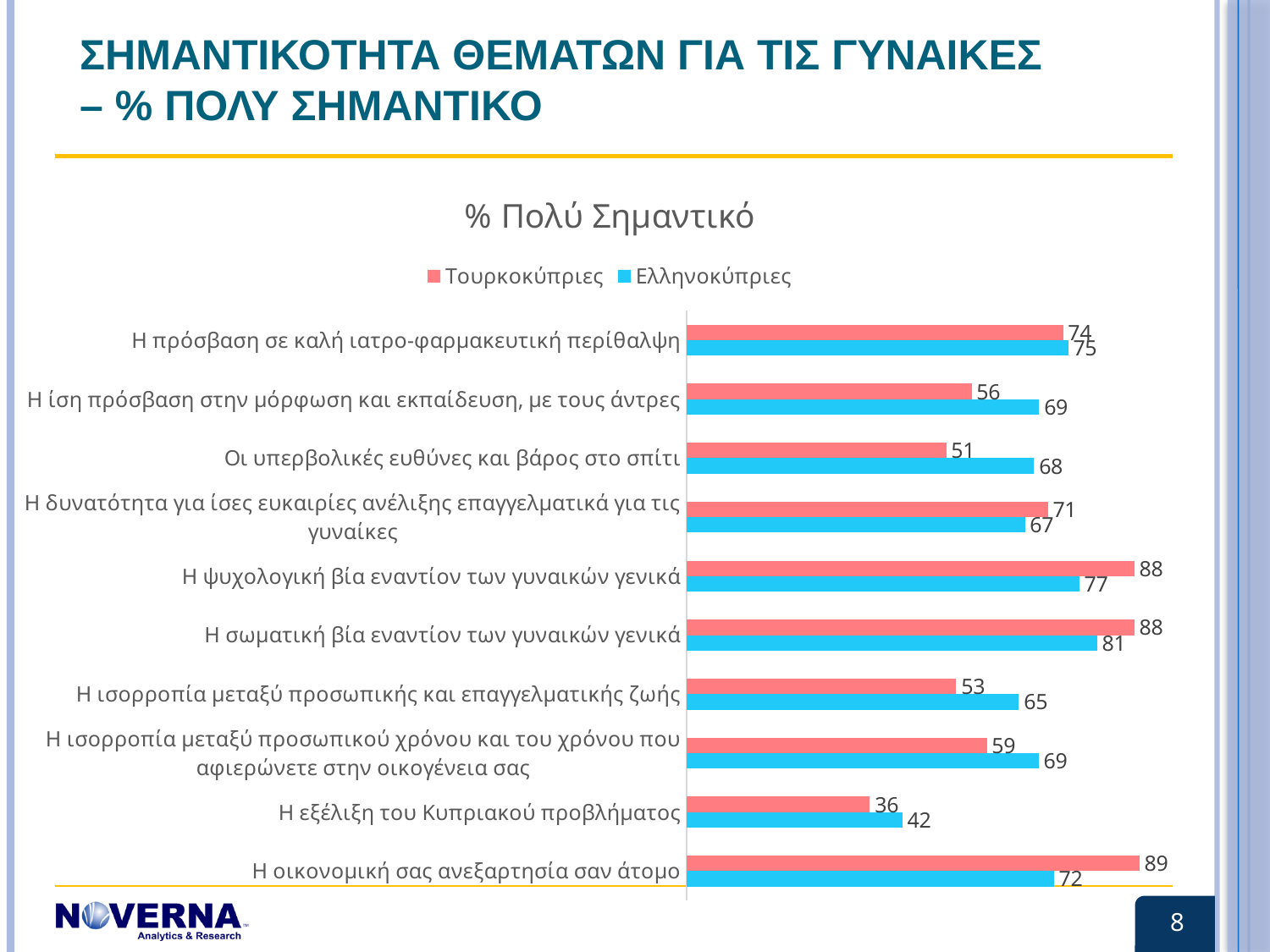
For 'Η δυνατότητα για ίσες ευκαιρίες ανέλιξης επαγγελματικά για τις γυναίκες', which group has the larger value, Τουρκοκύπριες or Ελληνοκύπριες? Τουρκοκύπριες Which category has the highest value for Τουρκοκύπριες? Η οικονομική σας ανεξαρτησία σαν άτομο What is the value for Ελληνοκύπριες for 'Η σωματική βία εναντίον των γυναικών γενικά'? 81 Which category has the lowest value for Ελληνοκύπριες? Η εξέλιξη του Κυπριακού προβλήματος What is the difference between the Τουρκοκύπριες and Ελληνοκύπριες values for 'Η οικονομική σας ανεξαρτησία σαν άτομο'? 17 What is the value for Ελληνοκύπριες for 'Οι υπερβολικές ευθύνες και βάρος στο σπίτι'? 68 What is the difference between the Ελληνοκύπριες and Τουρκοκύπριες values for 'Η ίση πρόσβαση στην μόρφωση και εκπαίδευση, με τους άντρες'? 13 What is the value for Τουρκοκύπριες for 'Η εξέλιξη του Κυπριακού προβλήματος'? 36 How many series does the legend list? 2 How many categories are shown in the chart? 10 What type of chart is shown on the slide? Bar chart Which category has the highest value for Ελληνοκύπριες? Η σωματική βία εναντίον των γυναικών γενικά